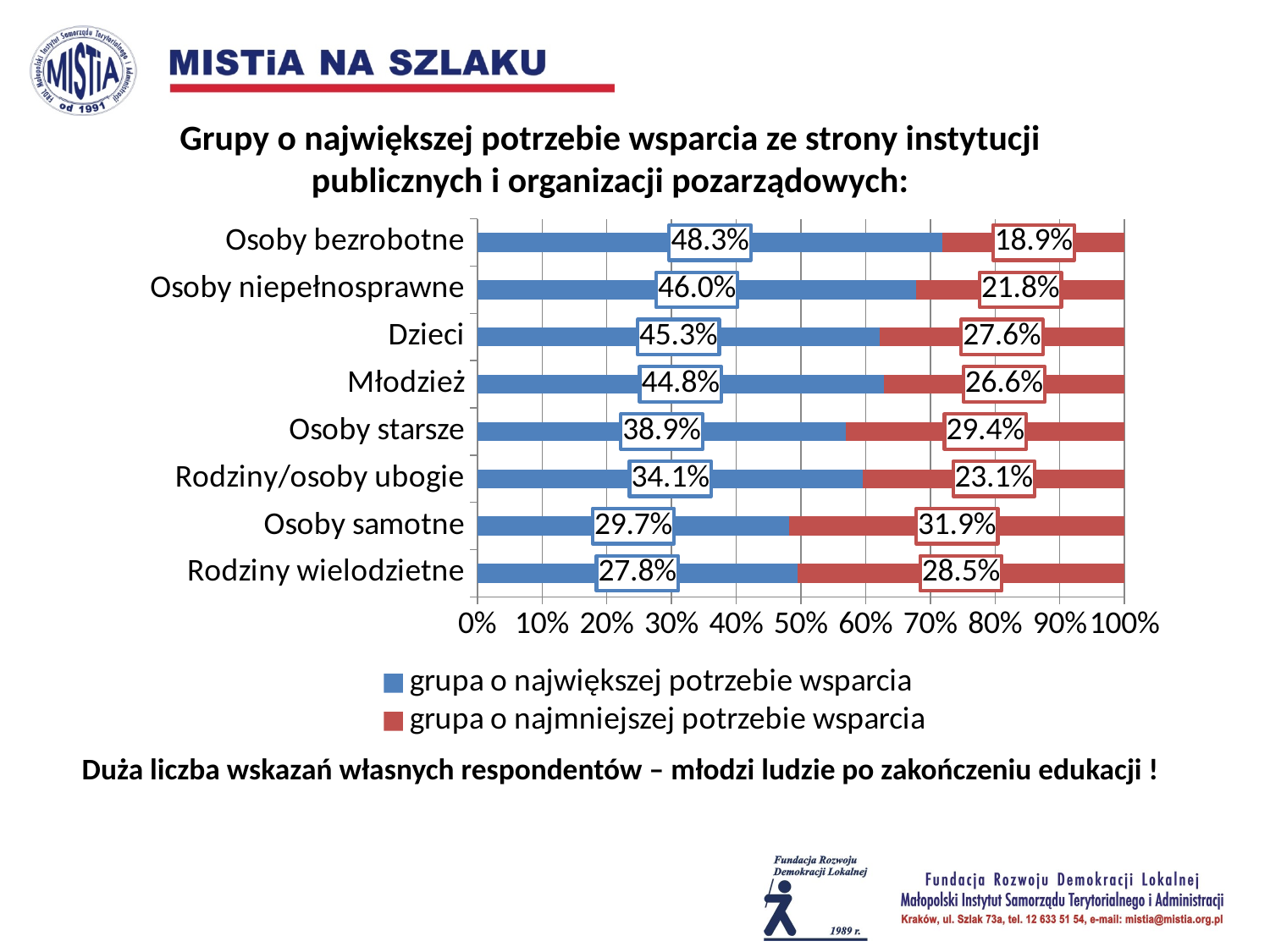
Which category has the lowest value in the series 'grupa o najmniejszej potrzebie wsparcia'? Osoby bezrobotne What is the value for Rodziny/osoby ubogie in the series 'grupa o największej potrzebie wsparcia'? 34.1% What is the difference between the two series values for Osoby bezrobotne? 29.4 percentage points What is the value for Osoby starsze in the series 'grupa o najmniejszej potrzebie wsparcia'? 29.4% How many categories are shown on the chart? 8 What is the value for Osoby bezrobotne in the series 'grupa o największej potrzebie wsparcia'? 48.3% What kind of chart is shown on the slide? Stacked bar chart For Osoby samotne, which series has the larger value: 'grupa o największej potrzebie wsparcia' or 'grupa o najmniejszej potrzebie wsparcia'? grupa o najmniejszej potrzebie wsparcia Which category has the highest value in the series 'grupa o najmniejszej potrzebie wsparcia'? Osoby samotne Which category has the highest value in the series 'grupa o największej potrzebie wsparcia'? Osoby bezrobotne What colour represents the series 'grupa o najmniejszej potrzebie wsparcia'? Red How many series does the legend list? 2